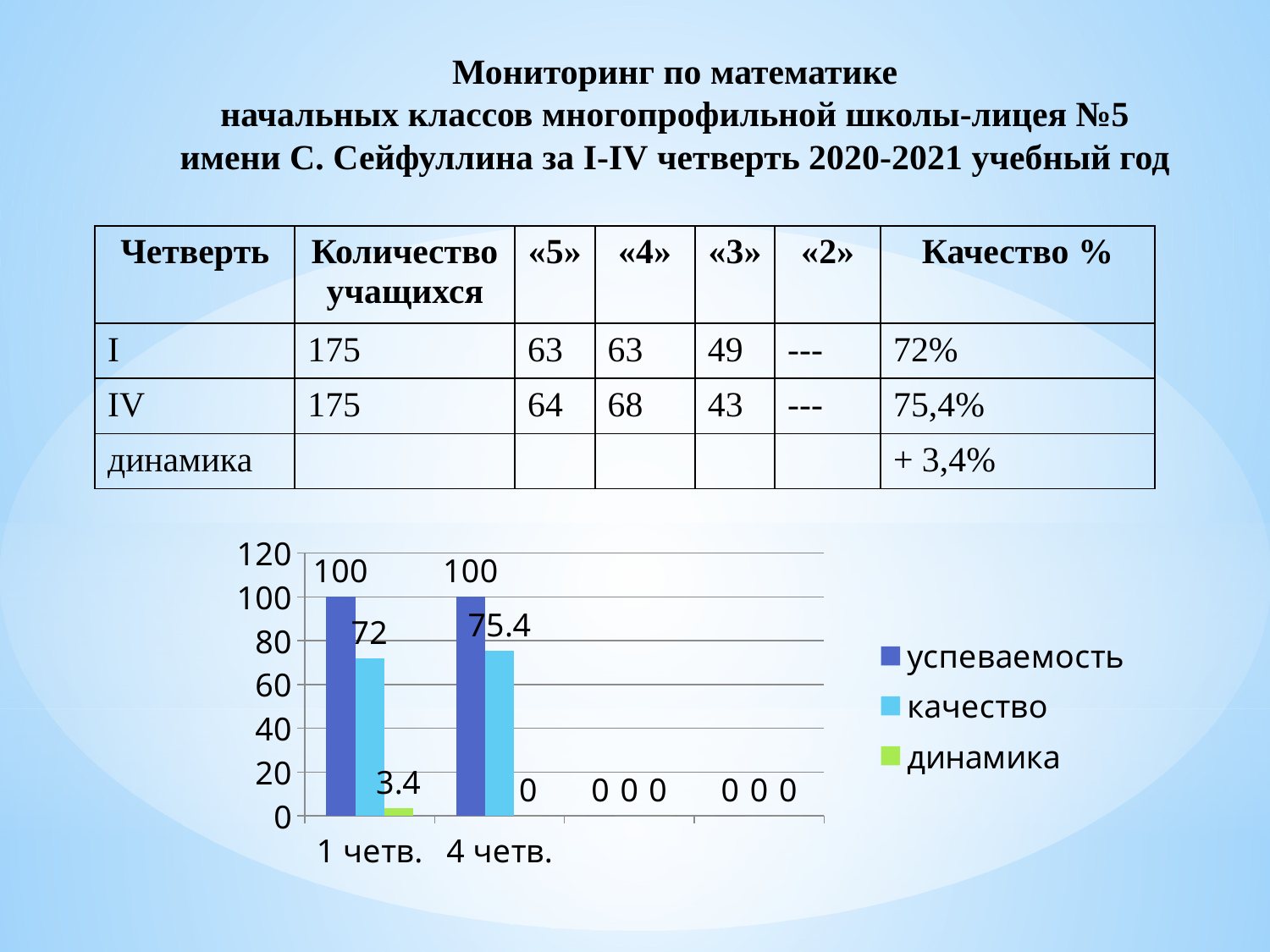
What type of chart is shown on the slide? bar chart Which series has the highest value for 1 четв.? успеваемость How many series does the chart legend list? 3 What is the difference between качество for 4 четв. and качество for 1 четв.? 3.4 Which is larger: качество for 1 четв. or качество for 4 четв.? 4 четв. Does the value of качество rise or fall from 1 четв. to 4 четв.? rise What is the value of качество for 4 четв.? 75.4 What is the value of динамика for 4 четв.? 0 What is the value of динамика for 1 четв.? 3.4 What is the value of успеваемость for 4 четв.? 100 What is the value of качество for 1 четв.? 72 Which series has the lowest value for 1 четв.? динамика